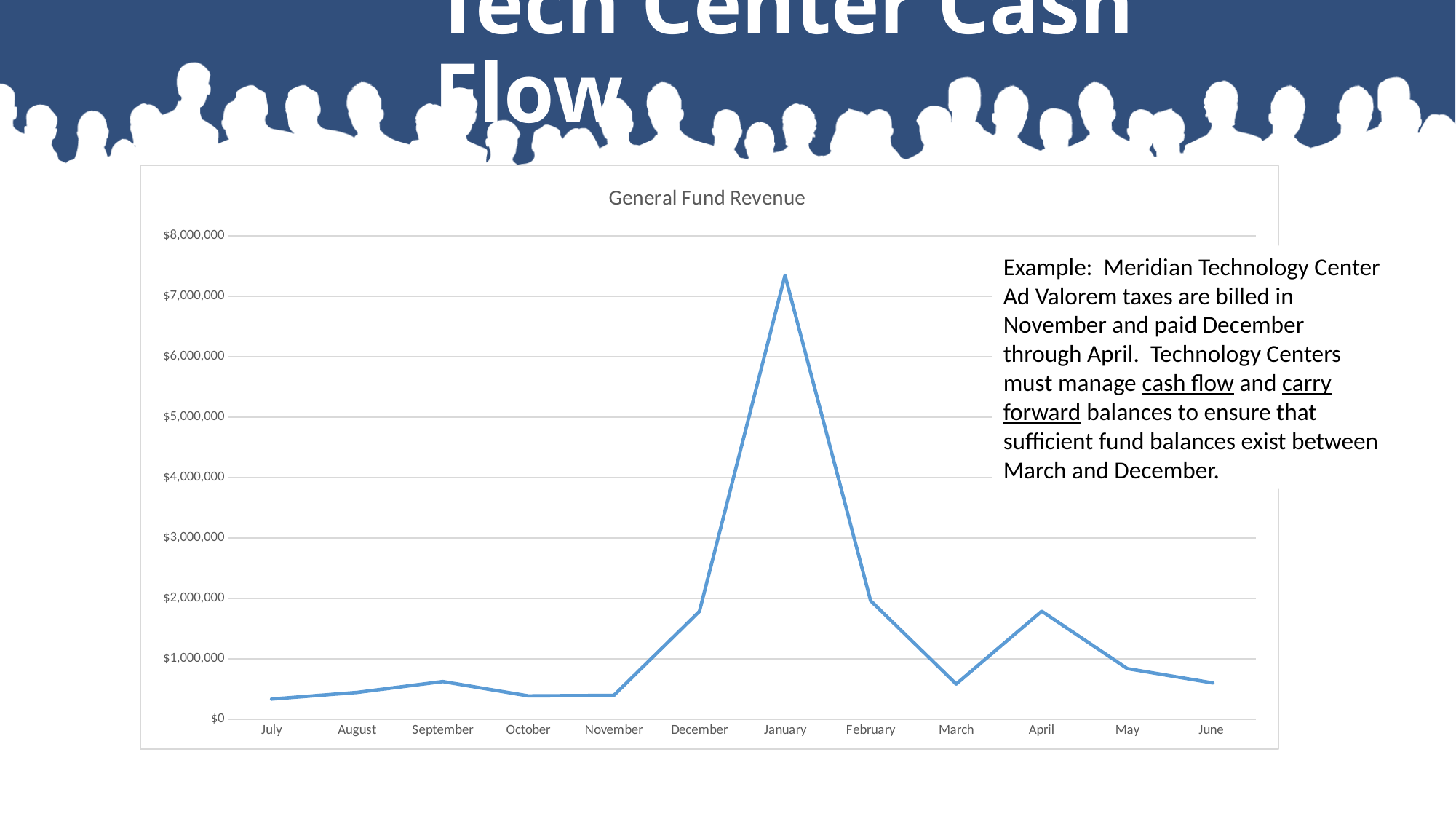
Is the value for December greater or less than $2,000,000? less Which is larger, the value for April or the value for March? April Which is larger, the value for January or the value for February? January Is the value for March greater or less than $1,000,000? less Is the value for July greater or less than $1,000,000? less What kind of chart is shown on the slide? line chart What is the title of the chart? General Fund Revenue Which month has the highest General Fund Revenue? January Do the values rise or fall from January to March? fall How many months are plotted along the x axis of the chart? 12